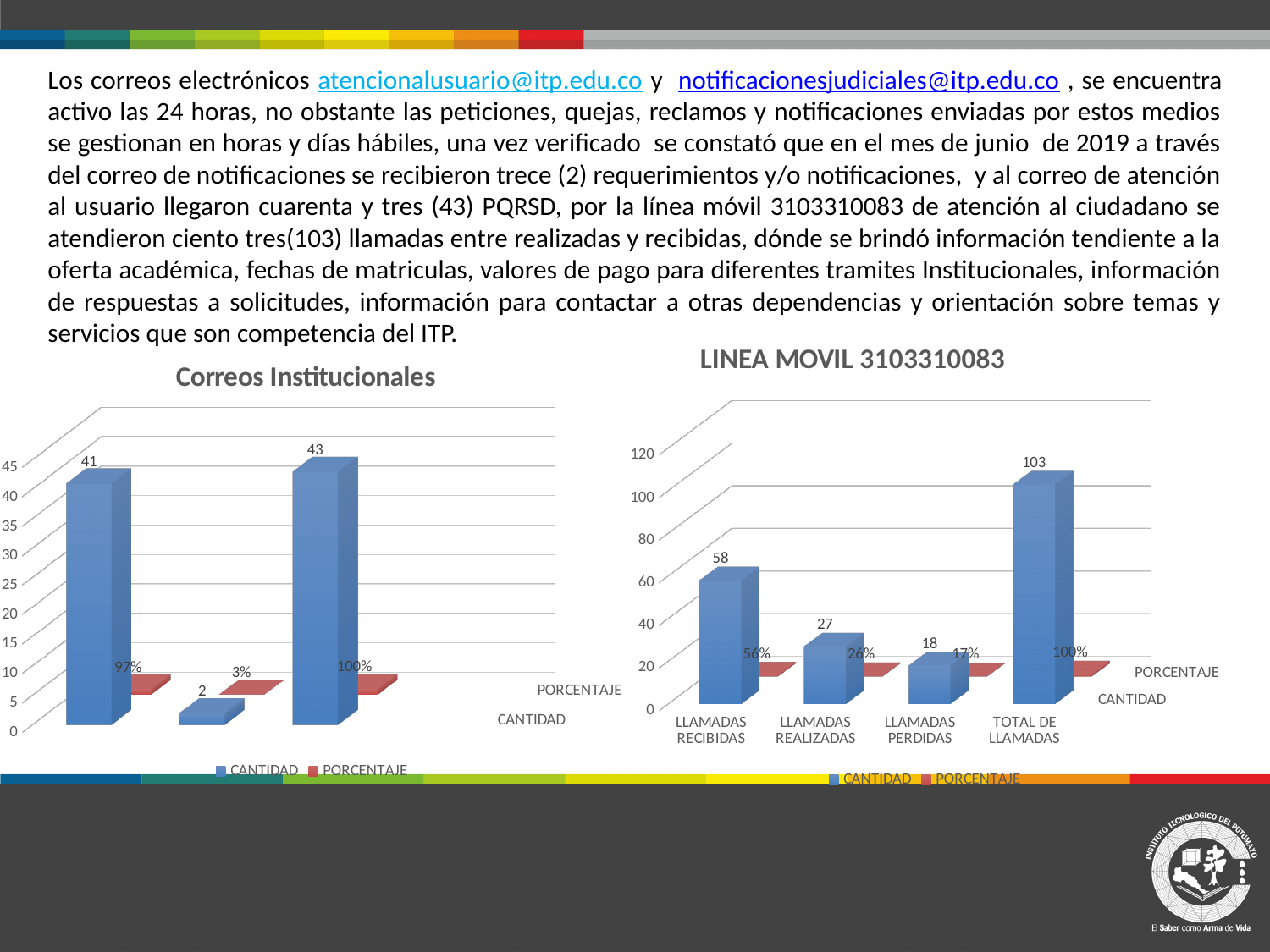
How many series does the legend of the LINEA MOVIL 3103310083 chart list? 2 In the LINEA MOVIL 3103310083 chart, which has a larger CANTIDAD: LLAMADAS REALIZADAS or LLAMADAS PERDIDAS? LLAMADAS REALIZADAS In the LINEA MOVIL 3103310083 chart, what PORCENTAJE is shown for LLAMADAS REALIZADAS? 26% In the LINEA MOVIL 3103310083 chart, which category has the highest CANTIDAD value? TOTAL DE LLAMADAS What are the two series listed in the legend of the Correos Institucionales chart? CANTIDAD and PORCENTAJE What type of chart is the Correos Institucionales chart? Bar chart In the LINEA MOVIL 3103310083 chart, what is the difference in CANTIDAD between LLAMADAS RECIBIDAS and LLAMADAS REALIZADAS? 31 How many categories are shown on the x axis of the LINEA MOVIL 3103310083 chart? 4 In the LINEA MOVIL 3103310083 chart, what is the CANTIDAD value for LLAMADAS RECIBIDAS? 58 In the LINEA MOVIL 3103310083 chart, which category has the lowest CANTIDAD value? LLAMADAS PERDIDAS What is the highest CANTIDAD value shown in the Correos Institucionales chart? 43 In the LINEA MOVIL 3103310083 chart, what is the CANTIDAD value for LLAMADAS PERDIDAS? 18